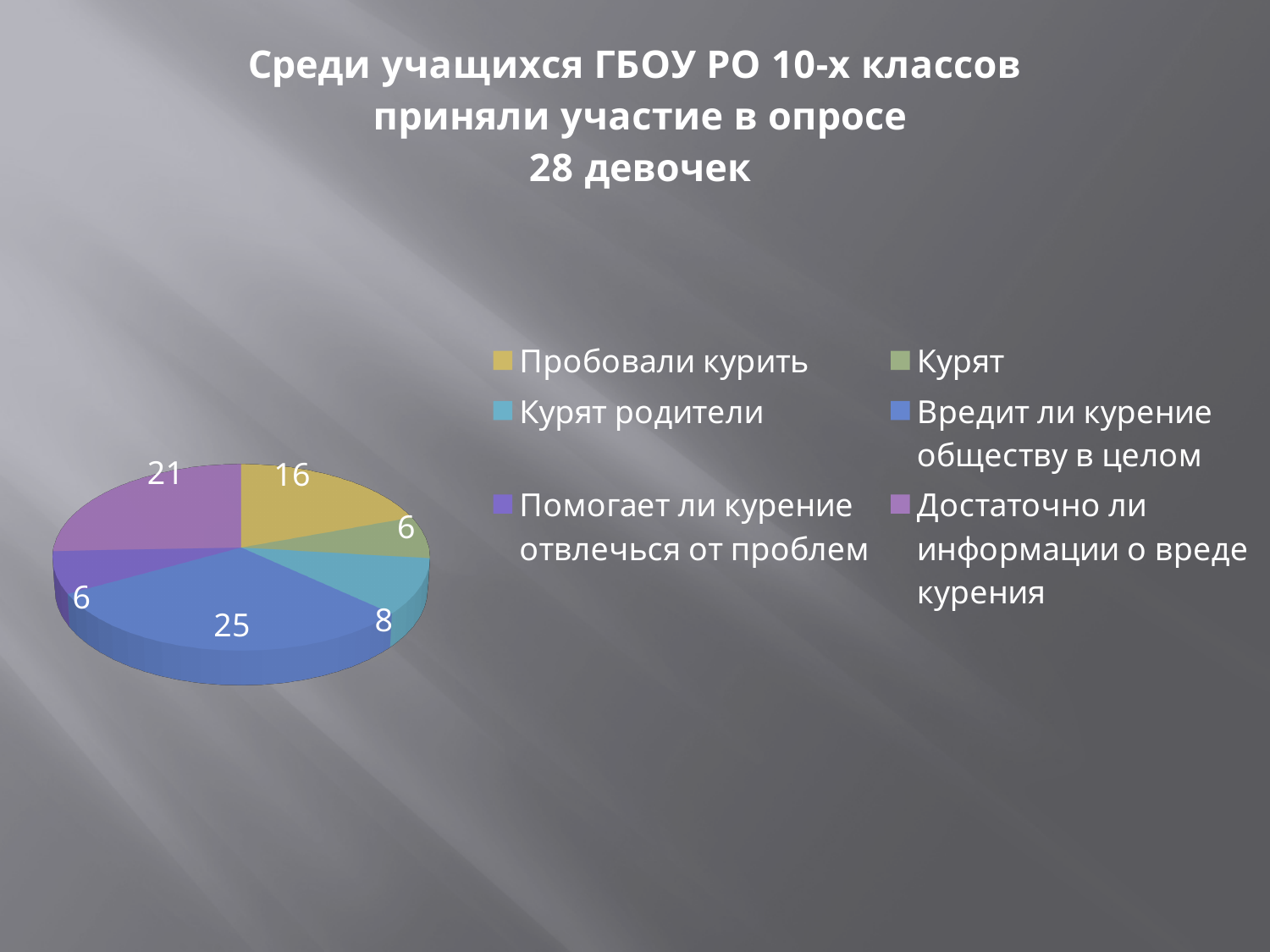
What is the value for "Курят"? 6 Which is larger: the value for "Пробовали курить" or the value for "Курят родители"? Пробовали курить Which category has the largest slice of the pie? Вредит ли курение обществу в целом What colour is the slice for "Достаточно ли информации о вреде курения"? purple What is the value for "Курят родители"? 8 What is the difference between the values for "Пробовали курить" and "Курят"? 10 How many categories does the pie chart have? 6 What is the difference between the values for "Вредит ли курение обществу в целом" and "Достаточно ли информации о вреде курения"? 4 What is the value for "Пробовали курить"? 16 What is the value for "Вредит ли курение обществу в целом"? 25 What kind of chart is shown on the slide? pie chart What is the value for "Достаточно ли информации о вреде курения"? 21